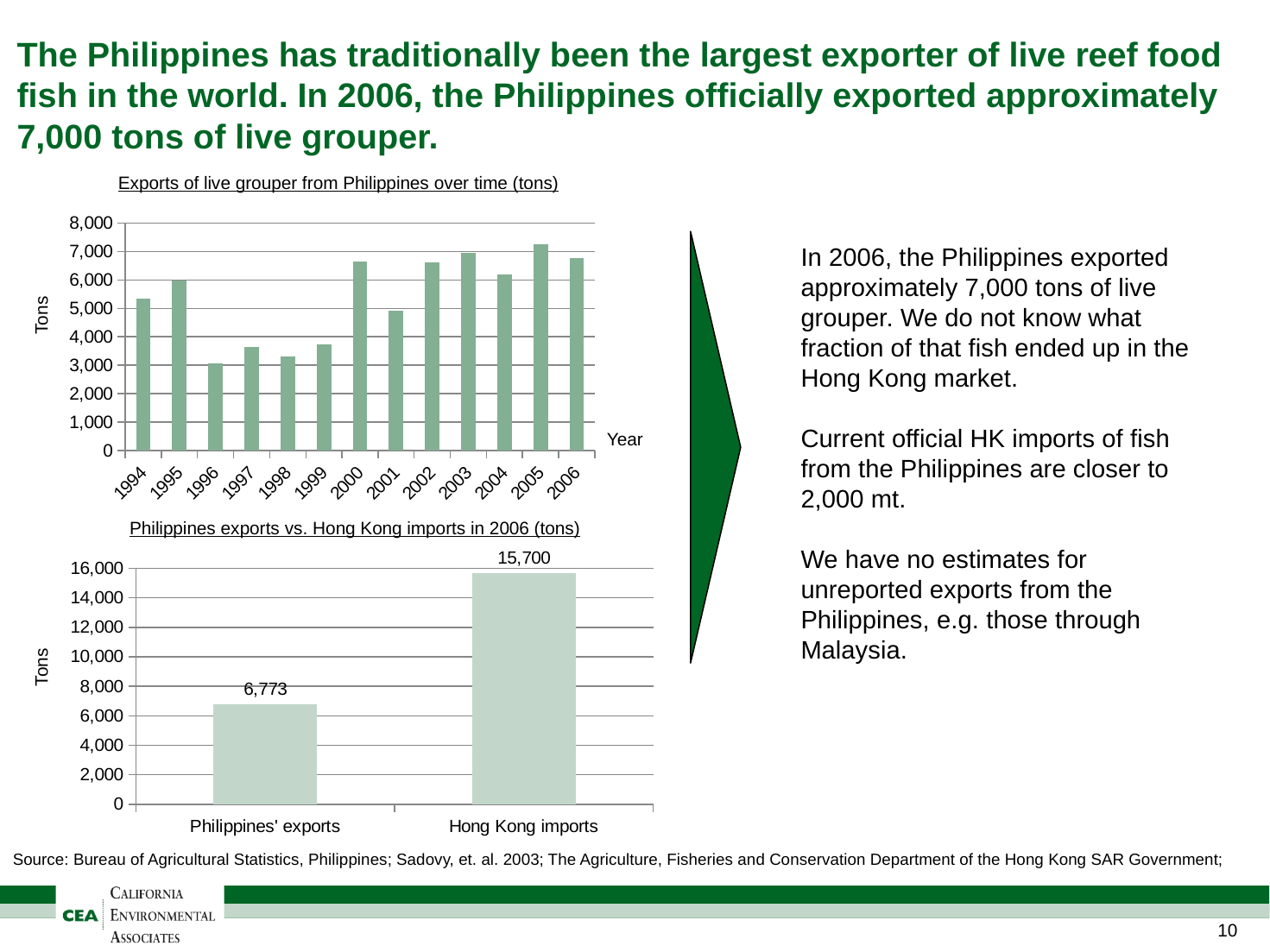
In the chart 'Exports of live grouper from Philippines over time (tons)', which year has the lowest exports? 1996 What kind of chart is 'Exports of live grouper from Philippines over time (tons)'? Bar chart In the chart 'Philippines exports vs. Hong Kong imports in 2006 (tons)', what is the value for Hong Kong imports? 15,700 In the chart 'Philippines exports vs. Hong Kong imports in 2006 (tons)', which is larger: Philippines' exports or Hong Kong imports? Hong Kong imports How many years are shown on the x axis of the chart 'Exports of live grouper from Philippines over time (tons)'? 13 In the chart 'Exports of live grouper from Philippines over time (tons)', is the value for 1996 greater or less than 4,000? less In the chart 'Philippines exports vs. Hong Kong imports in 2006 (tons)', what is the difference between Hong Kong imports and Philippines' exports? 8,927 How many bars are shown in the chart 'Philippines exports vs. Hong Kong imports in 2006 (tons)'? 2 In the chart 'Exports of live grouper from Philippines over time (tons)', which is larger: the value for 2000 or the value for 2001? 2000 In the chart 'Exports of live grouper from Philippines over time (tons)', which year has the highest exports? 2005 In the chart 'Philippines exports vs. Hong Kong imports in 2006 (tons)', what is the value for Philippines' exports? 6,773 In the chart 'Exports of live grouper from Philippines over time (tons)', is the value for 2005 greater or less than 7,000? greater